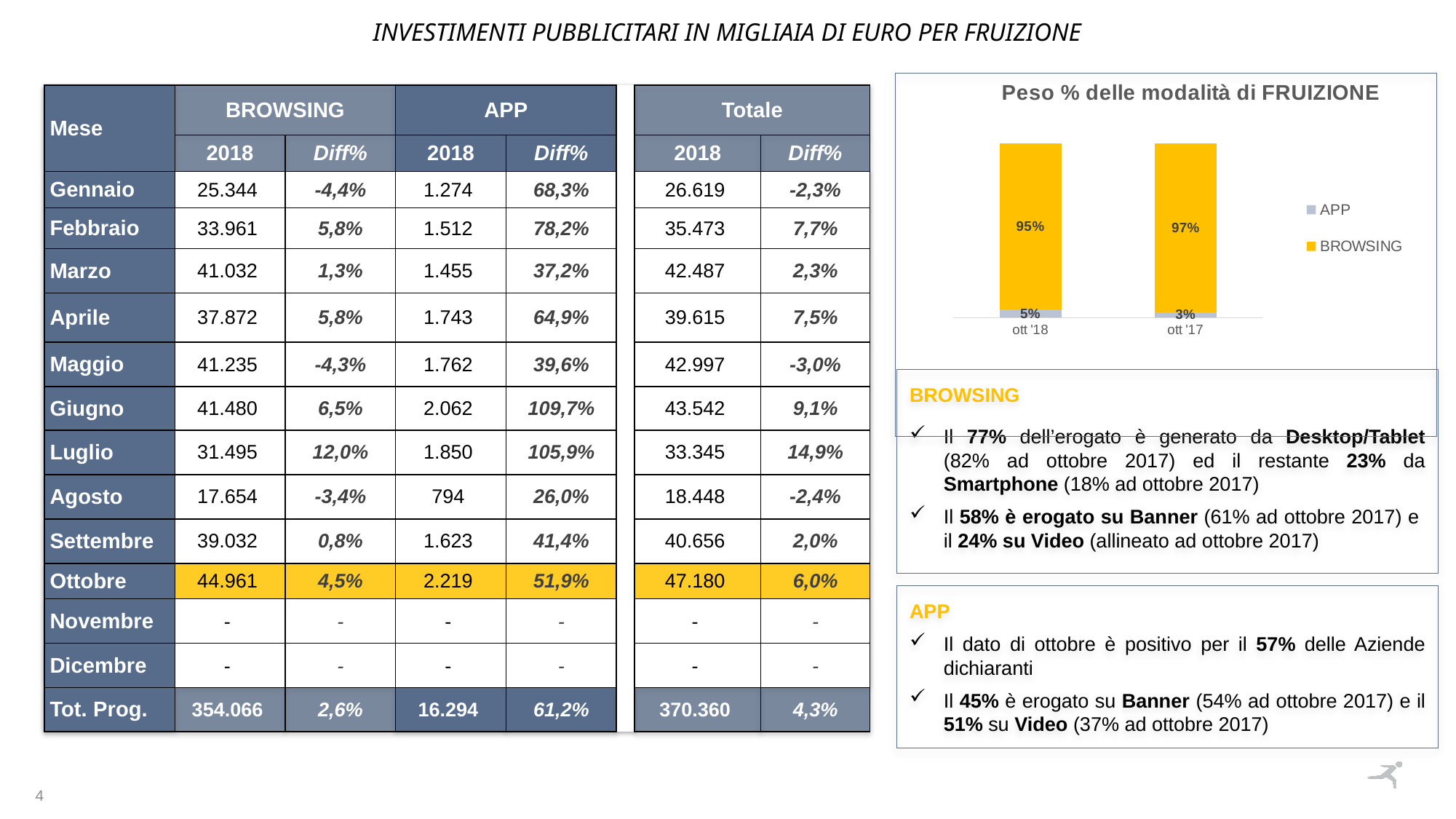
How many series does the legend of the chart 'Peso % delle modalità di FRUIZIONE' list? 2 In the chart 'Peso % delle modalità di FRUIZIONE', what is the BROWSING share for ott '18? 95% What is the title of the chart on the right of the slide? Peso % delle modalità di FRUIZIONE In the chart 'Peso % delle modalità di FRUIZIONE', what is the total of the stacked bar for ott '18? 100% In the chart 'Peso % delle modalità di FRUIZIONE', which period has the higher APP share, ott '18 or ott '17? ott '18 In the chart 'Peso % delle modalità di FRUIZIONE', what is the BROWSING share for ott '17? 97% How many bars are shown in the chart 'Peso % delle modalità di FRUIZIONE'? 2 In the chart 'Peso % delle modalità di FRUIZIONE', what is the APP share for ott '17? 3% In the chart 'Peso % delle modalità di FRUIZIONE', what is the difference between the BROWSING share in ott '17 and in ott '18? 2% What kind of chart is 'Peso % delle modalità di FRUIZIONE'? stacked bar chart In the chart 'Peso % delle modalità di FRUIZIONE', which colour represents the BROWSING series? yellow In the chart 'Peso % delle modalità di FRUIZIONE', what is the APP share for ott '18? 5%